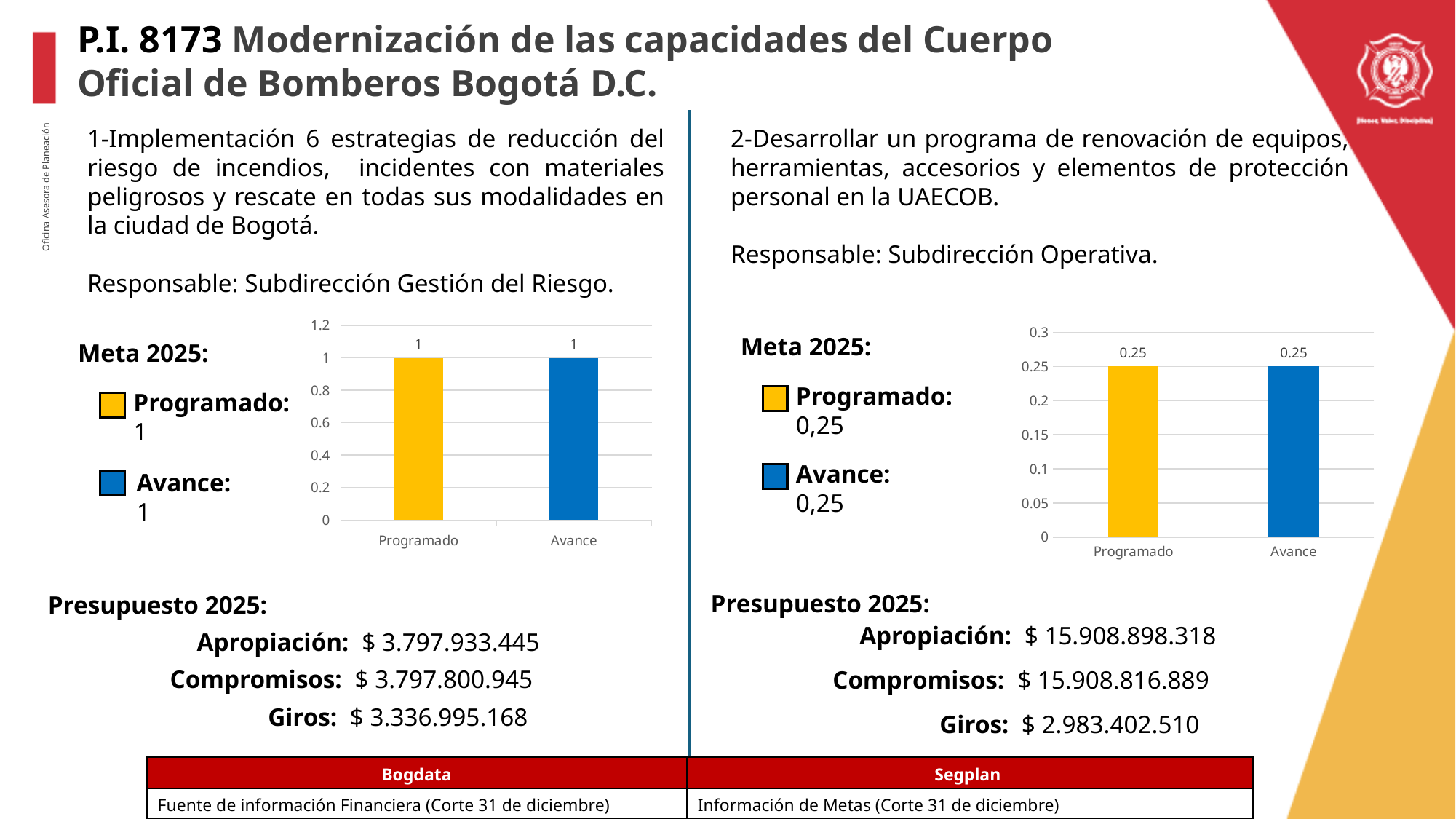
How many categories are shown on the x axis of the right chart? 2 In the left chart, what is the difference between the Programado and Avance values? 0 In the right chart, do the values rise, fall or stay the same from Programado to Avance? stay the same In the left chart, what colour is the Avance bar? blue In the left chart, is the value for Avance greater or less than 0.8? greater In the right chart, is the value for Programado greater or less than 0.2? greater In the left chart, what is the value for Avance? 1 In the right chart, what is the difference between the Programado and Avance values? 0 In the left chart, what is the value for Programado? 1 In the right chart, what is the value for Avance? 0.25 In the right chart, what is the value for Programado? 0.25 What kind of chart is the left chart? bar chart